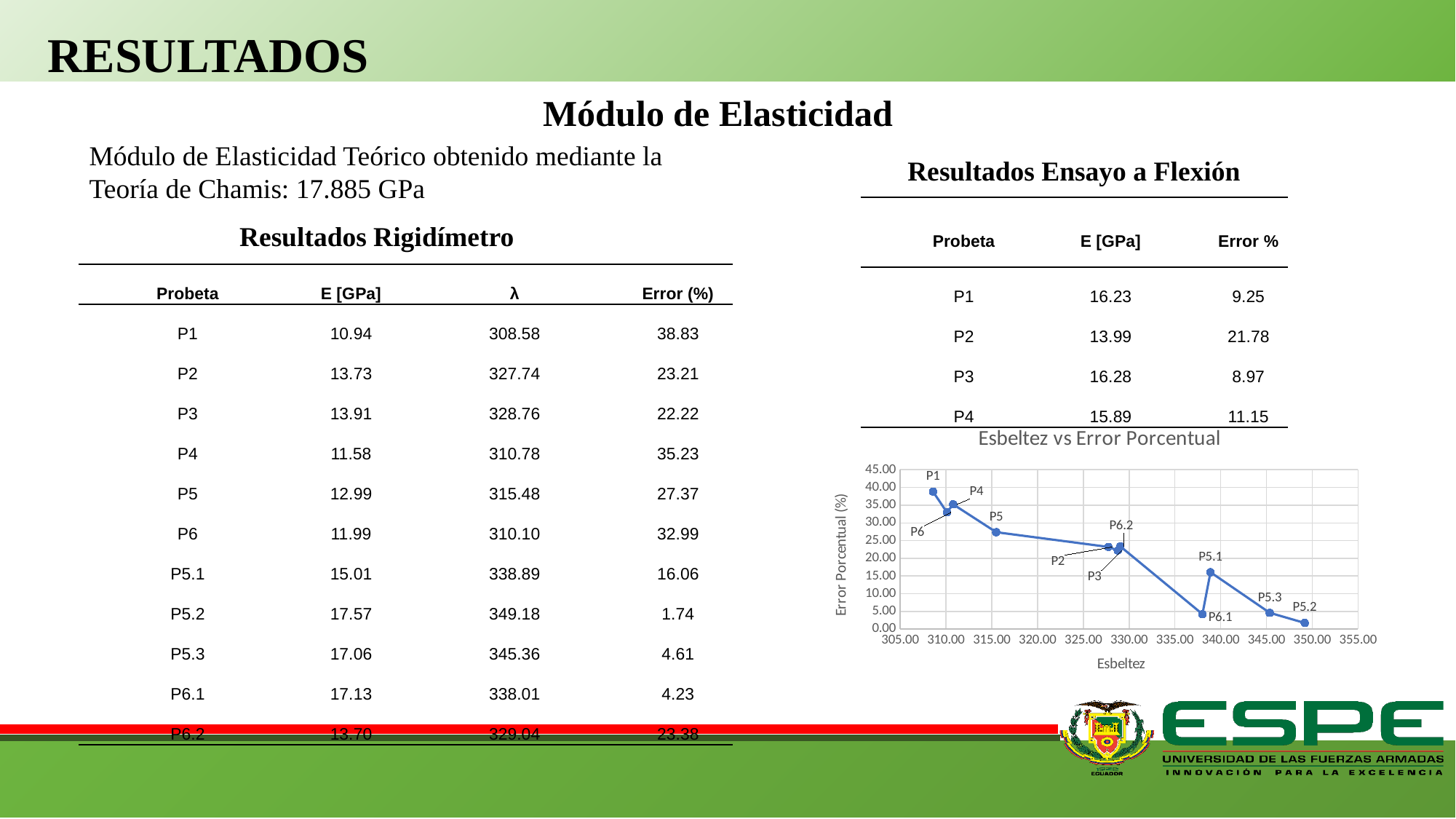
In the "Esbeltez vs Error Porcentual" chart, is the error percentage for P6.1 greater or less than 10.00? less What is the title of the chart on the slide? Esbeltez vs Error Porcentual In the "Esbeltez vs Error Porcentual" chart, which labelled point has the highest error percentage? P1 What is the label of the horizontal axis in the "Esbeltez vs Error Porcentual" chart? Esbeltez In the "Esbeltez vs Error Porcentual" chart, is the error percentage for P4 greater or less than 30.00? greater In the "Esbeltez vs Error Porcentual" chart, which has a higher error percentage, P5.1 or P6.1? P5.1 In the "Esbeltez vs Error Porcentual" chart, is the error percentage for P1 greater or less than 35.00? greater What kind of chart is "Esbeltez vs Error Porcentual"? line chart In the "Esbeltez vs Error Porcentual" chart, does the error percentage generally rise or fall as Esbeltez increases? fall How many data points are plotted in the "Esbeltez vs Error Porcentual" chart? 11 In the "Esbeltez vs Error Porcentual" chart, which labelled point has the lowest error percentage? P5.2